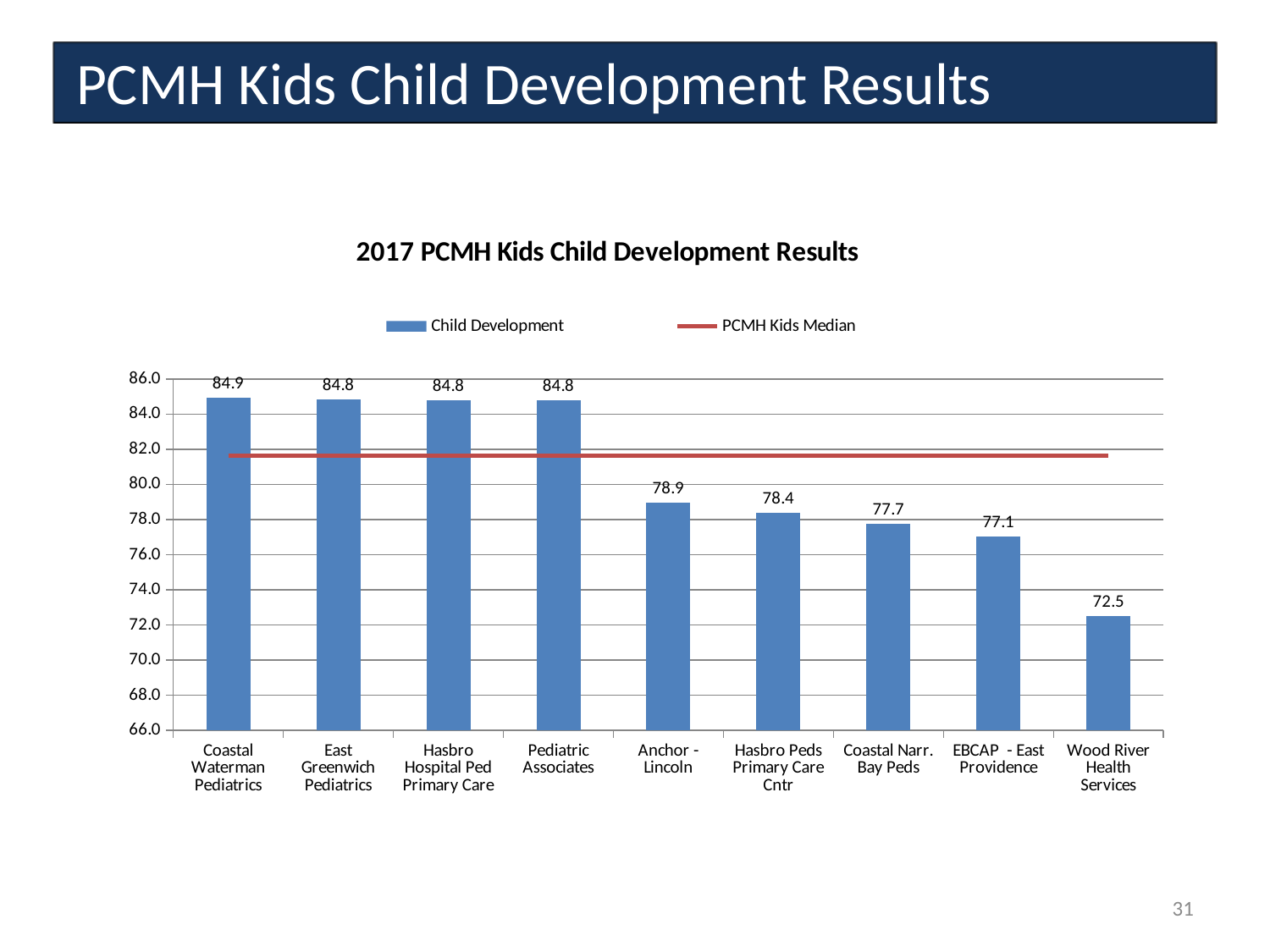
How many practices are shown on the x axis? 9 What is the Child Development value for Coastal Waterman Pediatrics? 84.9 What is the difference between the Child Development values for Anchor - Lincoln and Hasbro Peds Primary Care Cntr? 0.5 What is the Child Development value for Anchor - Lincoln? 78.9 What is the Child Development value for Wood River Health Services? 72.5 How many series does the legend list? 2 What is the difference between the Child Development values for Coastal Waterman Pediatrics and Wood River Health Services? 12.4 Which has a higher Child Development value, Pediatric Associates or Coastal Narr. Bay Peds? Pediatric Associates Do the Child Development values generally rise or fall from left to right? fall Is the PCMH Kids Median line greater or less than 80.0? greater What is the Child Development value for EBCAP - East Providence? 77.1 Which practice has the lowest Child Development value? Wood River Health Services